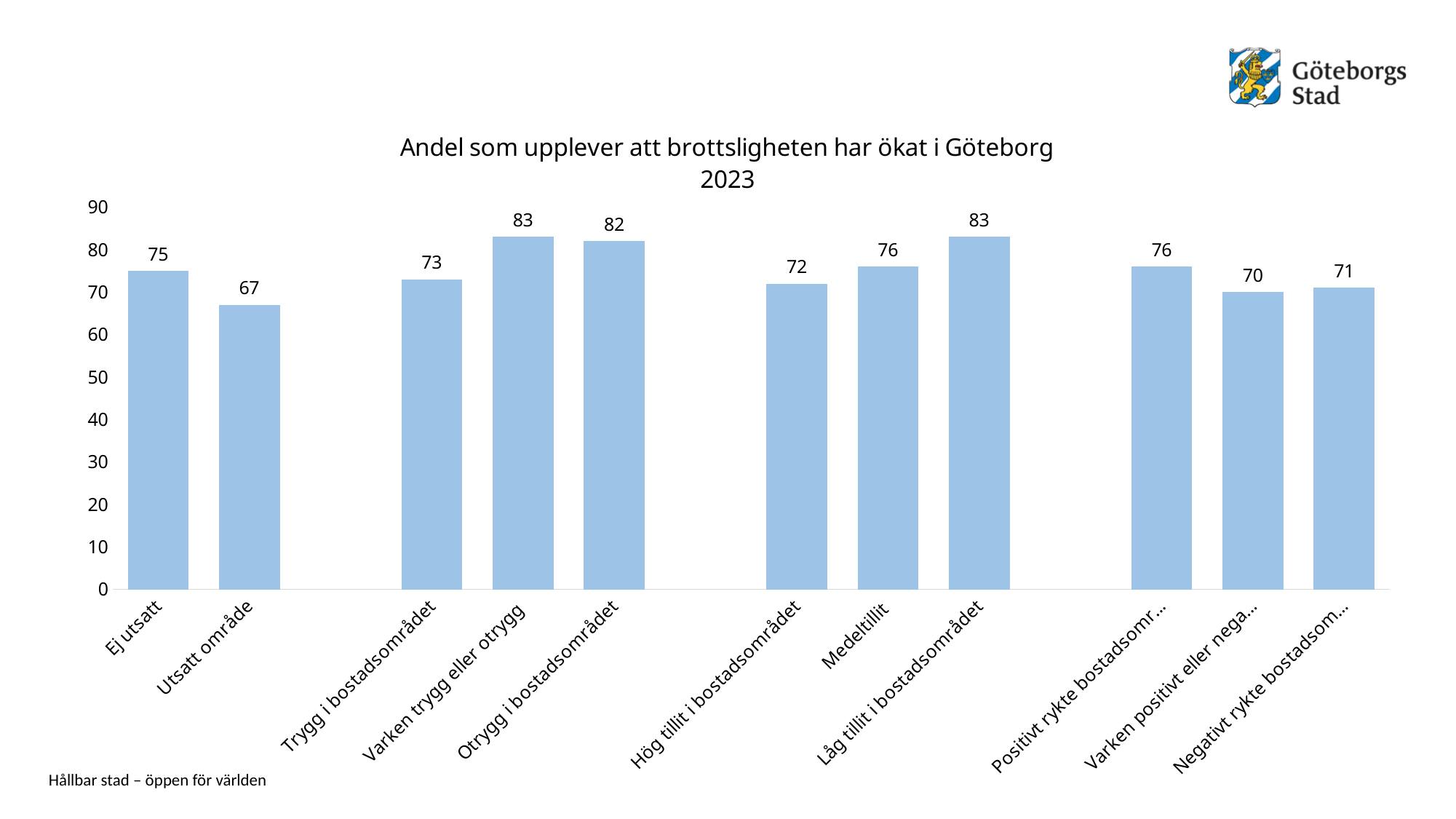
Is the value for Utsatt område greater or less than 70? less What is the difference between the values for Otrygg i bostadsområdet and Trygg i bostadsområdet? 9 What is the value for Utsatt område? 67 Which is larger, the value for Låg tillit i bostadsområdet or the value for Hög tillit i bostadsområdet? Låg tillit i bostadsområdet What is the value for Varken trygg eller otrygg? 83 What kind of chart is shown on the slide? bar chart Which category has the lowest value? Utsatt område What is the value for Ej utsatt? 75 What is the value for Hög tillit i bostadsområdet? 72 How many bars are shown in the chart? 11 What is the difference between the values for Ej utsatt and Utsatt område? 8 What is the value for Medeltillit? 76